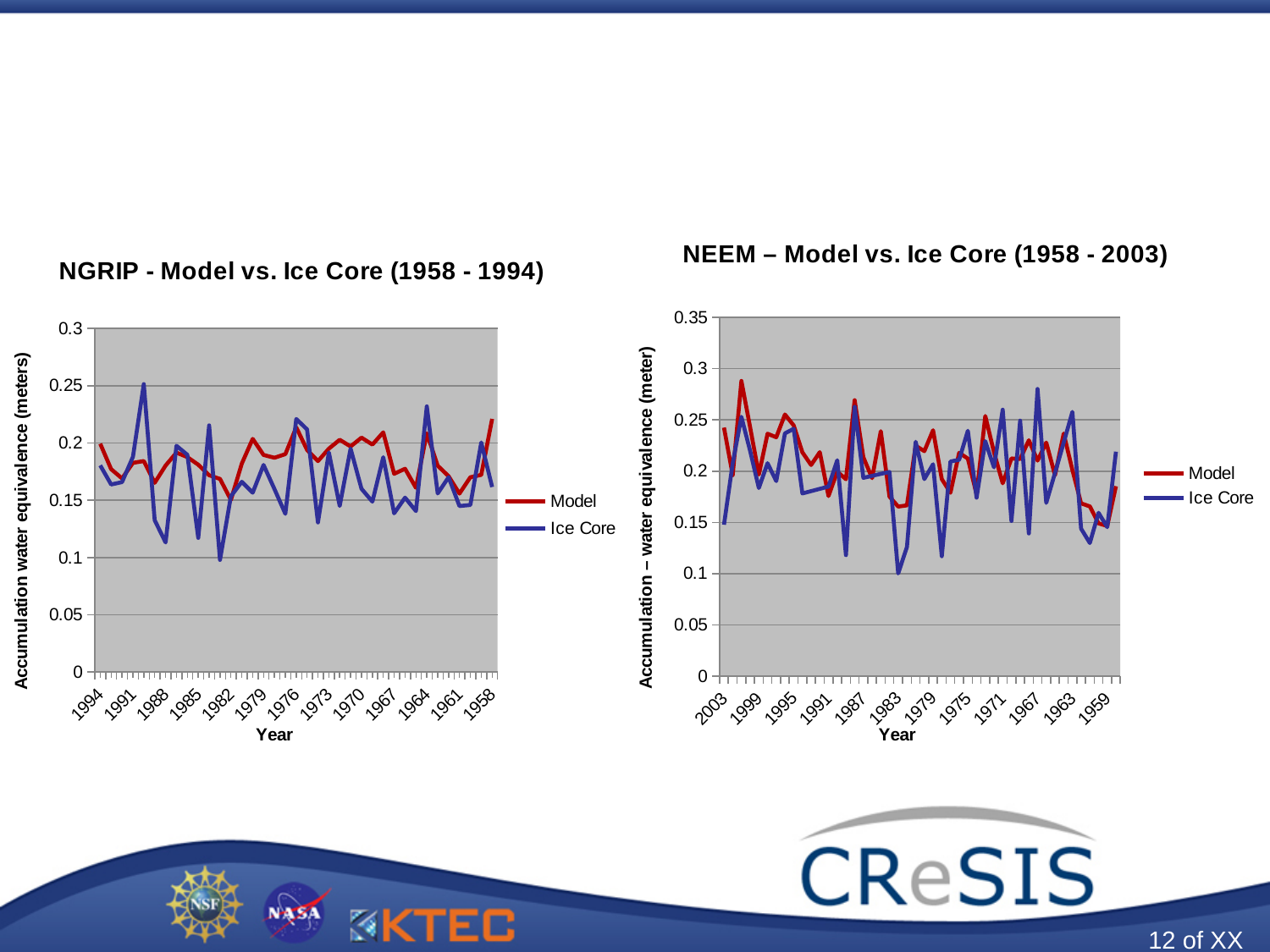
In the NGRIP chart, which series reaches the highest value plotted? Ice Core How many series does the legend of the NGRIP chart list? 2 In the NGRIP chart, is the Ice Core value for 1989 greater or less than 0.2? less What kind of chart is the NGRIP - Model vs. Ice Core (1958 - 1994) chart? Line chart How many series does the legend of the NEEM chart list? 2 In the NEEM chart, is the Ice Core value for 1983 greater or less than 0.15? less What are the two series named in the legend of the NGRIP chart? Model and Ice Core What kind of chart is the NEEM – Model vs. Ice Core (1958 - 2003) chart? Line chart In the NEEM chart, which series is drawn in blue? Ice Core In the NEEM chart, which series reaches the lowest value plotted? Ice Core